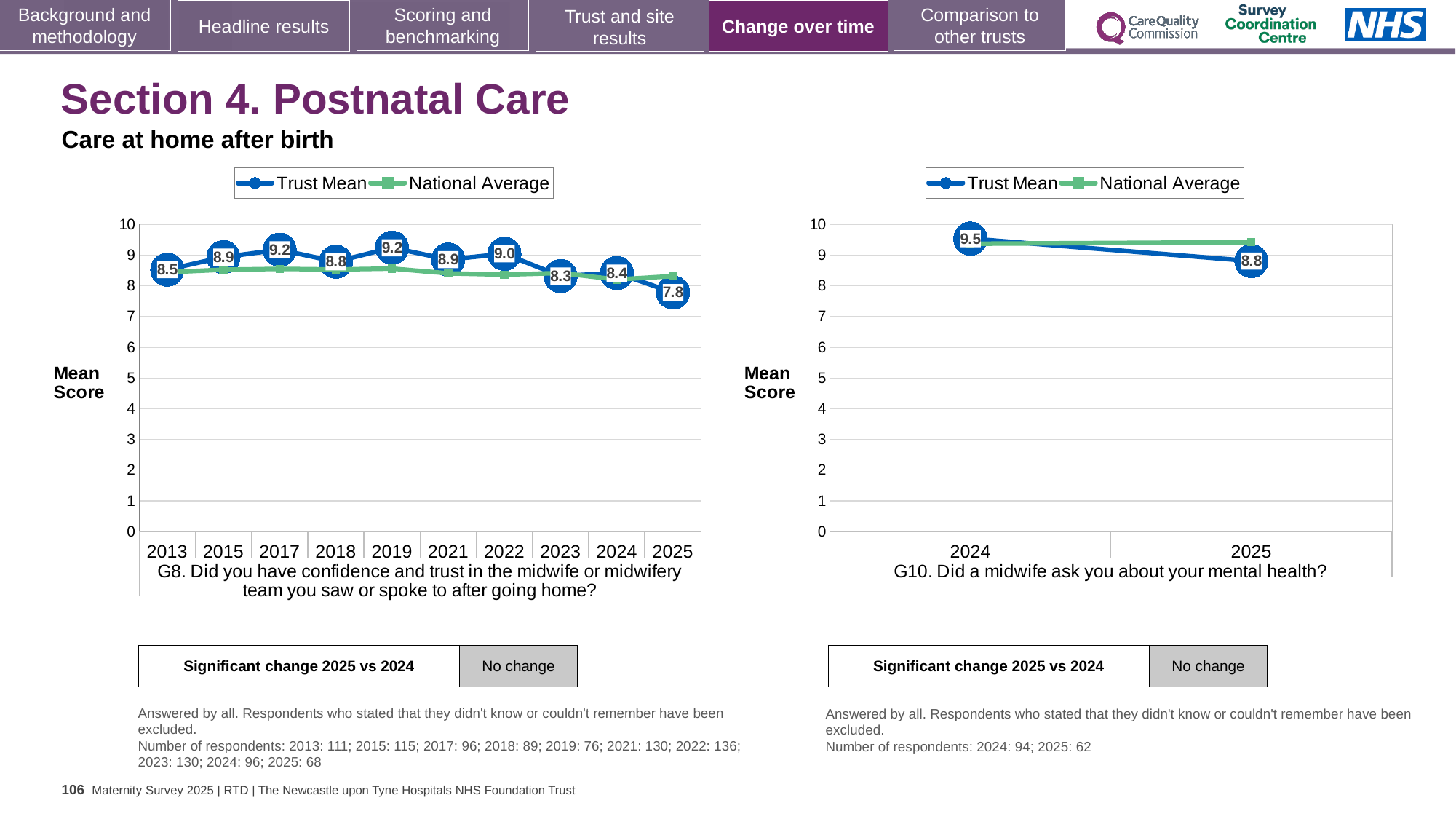
In the G8 chart, what is the Trust Mean for 2013? 8.5 In the G8 chart, which year has the lowest Trust Mean? 2025 In the G8 chart, what is the Trust Mean for 2025? 7.8 In the G8 chart, is the Trust Mean higher in 2017 or in 2023? 2017 In the G8 chart, is the National Average for 2025 greater or less than 8? greater How many series does the legend of the G10 chart list? 2 In the G8 chart, what is the Trust Mean for 2022? 9.0 In the G8 chart, how many years are shown on the x axis? 10 In the G10 chart, what is the difference between the Trust Mean in 2024 and in 2025? 0.7 In the G8 chart, what is the difference between the Trust Mean in 2024 and in 2025? 0.6 In the G10 chart, does the Trust Mean rise or fall from 2024 to 2025? fall In the G10 chart, what is the Trust Mean for 2024? 9.5